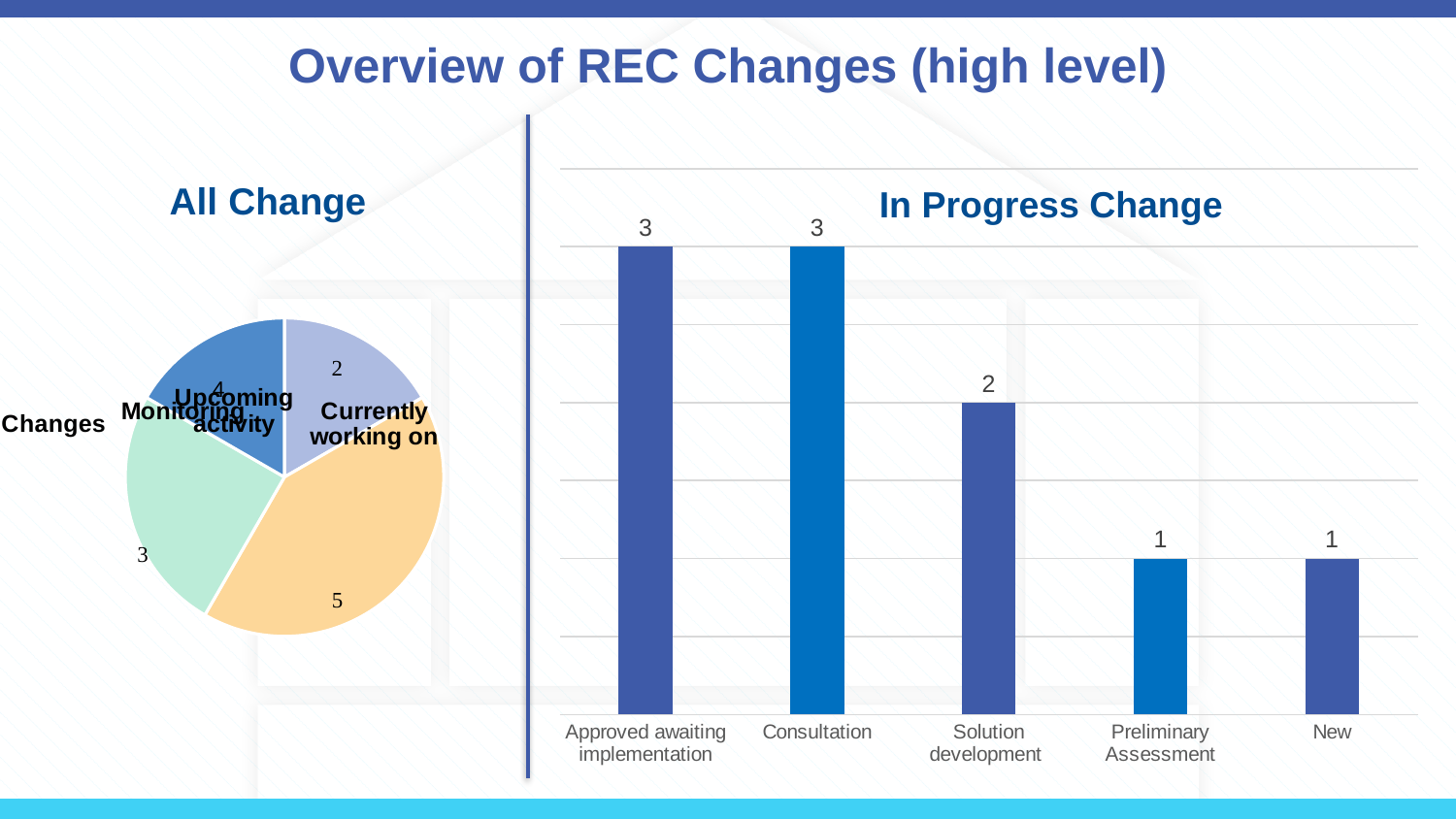
In the All Change pie chart, how many slices are there? 4 In the In Progress Change chart, what is the value for Approved awaiting implementation? 3 In the In Progress Change chart, what is the value for Consultation? 3 In the In Progress Change chart, what is the difference between Consultation and New? 2 In the In Progress Change chart, which is larger: Solution development or Preliminary Assessment? Solution development What kind of chart is the In Progress Change chart? Bar chart In the In Progress Change chart, do the values rise or fall from left to right? Fall In the In Progress Change chart, how many categories are shown on the x axis? 5 In the In Progress Change chart, what is the value for Solution development? 2 In the In Progress Change chart, what is the value for New? 1 What kind of chart is the All Change chart? Pie chart